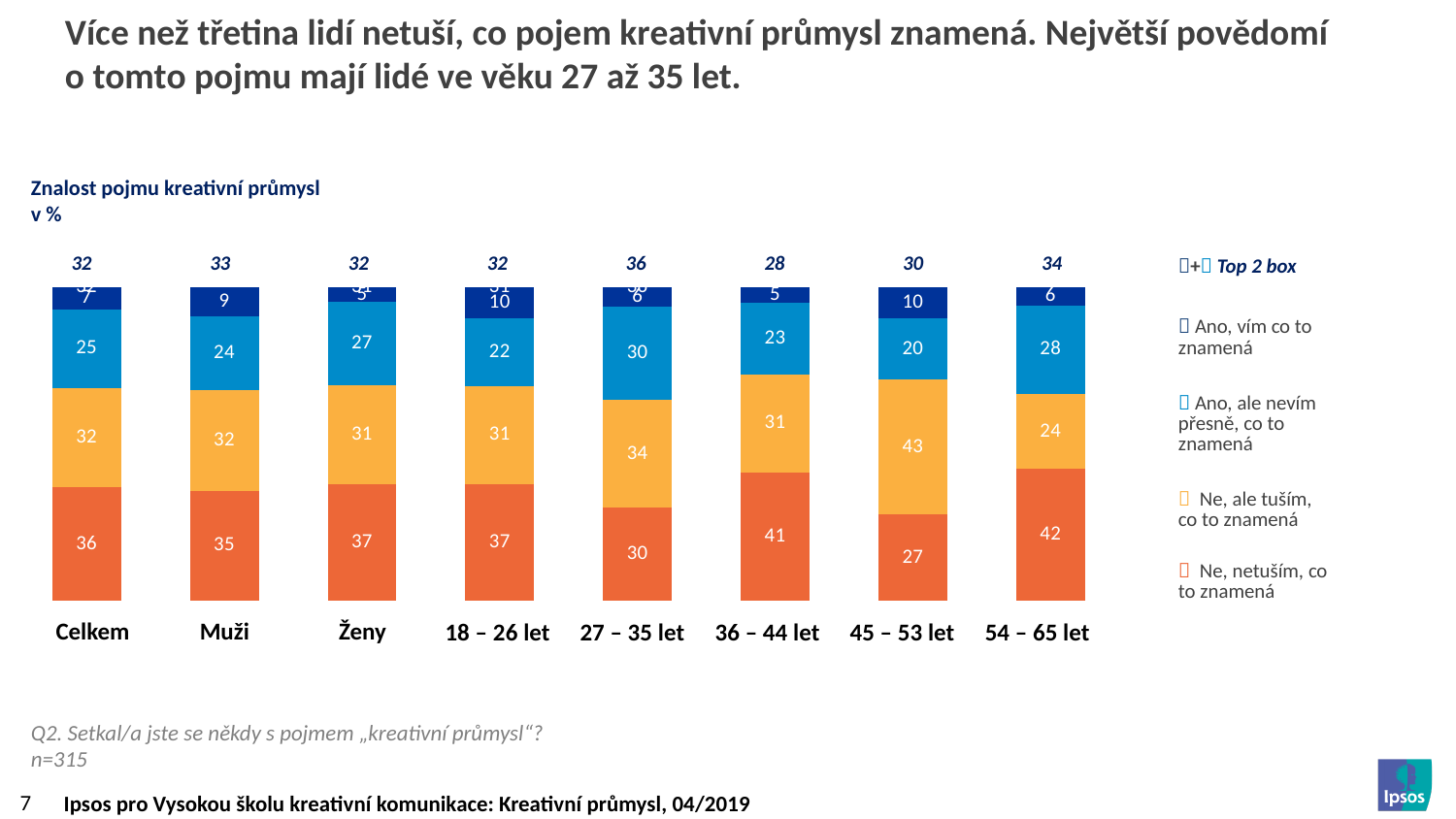
What is the value for "Ne, netuším, co to znamená" in the Celkem bar? 36 What is the value for "Ano, ale nevím přesně, co to znamená" in the 27 – 35 let bar? 30 What is the value for "Ano, vím co to znamená" in the Muži bar? 9 What is the difference between the "Ne, netuším, co to znamená" values for Ženy and Muži? 2 Which category has the lowest Top 2 box value shown above the bars? 36 – 44 let Which has a larger value for "Ne, ale tuším, co to znamená": 45 – 53 let or 36 – 44 let? 45 – 53 let What is the value for "Ne, ale tuším, co to znamená" in the 45 – 53 let bar? 43 How many series does the legend list (excluding the Top 2 box entry)? 4 Which category has the highest Top 2 box value shown above the bars? 27 – 35 let Which category has the highest value for "Ne, netuším, co to znamená"? 54 – 65 let How many categories (bars) are shown on the x axis? 8 What kind of chart is shown on the slide? Stacked bar chart